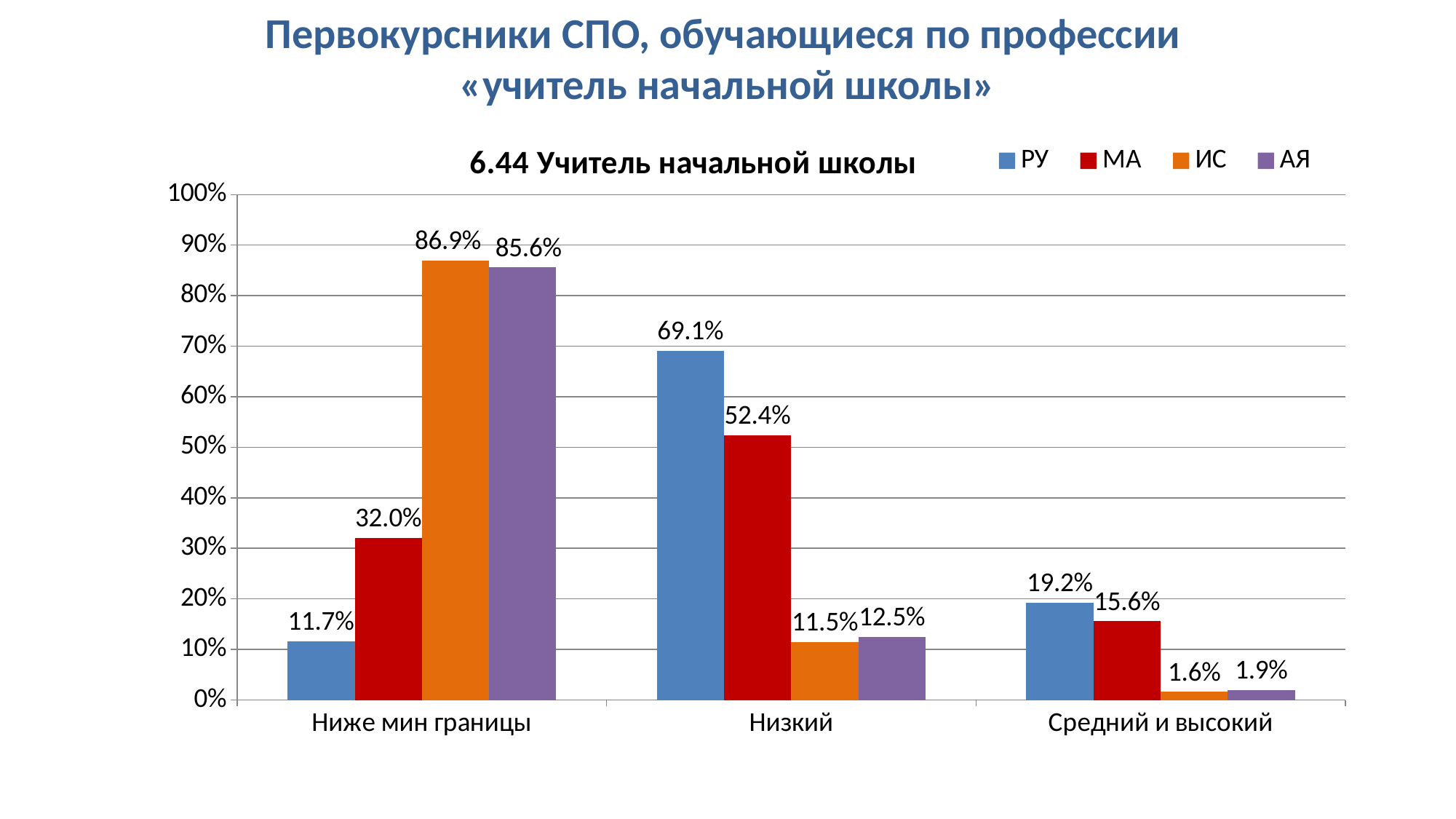
Which series has the highest value in the «Ниже мин границы» category? ИС How many categories are shown on the x axis? 3 Which series has the lowest value in the «Средний и высокий» category? ИС What is the value for РУ in the «Ниже мин границы» category? 11.7% Which is larger in the «Ниже мин границы» category: the value for ИС or the value for АЯ? ИС Is the value for РУ in the «Низкий» category greater or less than 60%? greater What is the value for МА in the «Низкий» category? 52.4% How many series does the legend list? 4 What is the difference between the РУ and МА values in the «Низкий» category? 16.7% What kind of chart is shown on the slide? Bar chart What is the value for АЯ in the «Средний и высокий» category? 1.9% What is the value for ИС in the «Низкий» category? 11.5%